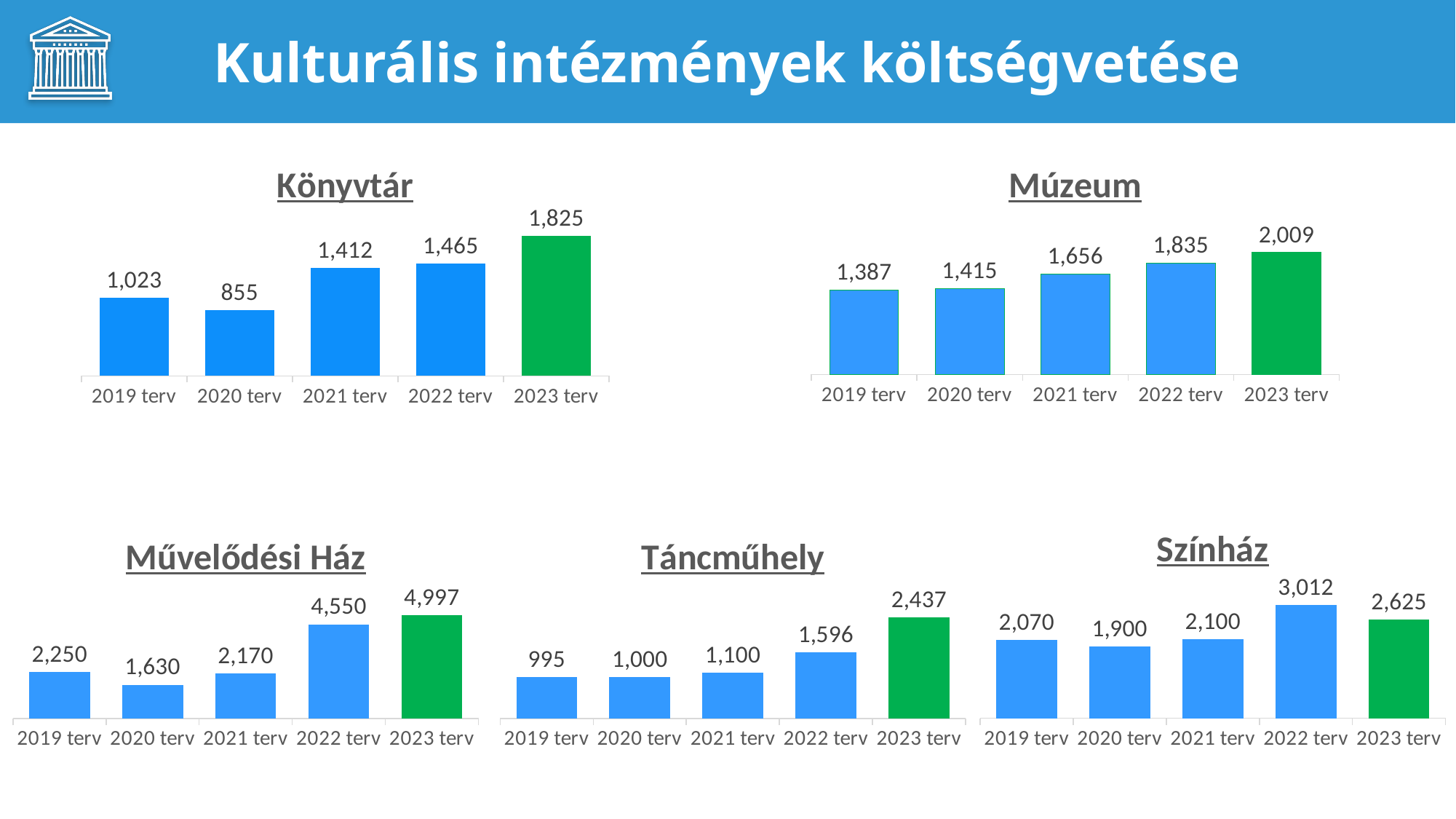
In the Múzeum chart, what is the value for 2021 terv? 1,656 In the Könyvtár chart, what is the value for 2023 terv? 1,825 What kind of chart is the Táncműhely chart? bar chart In the Színház chart, which is larger, the value for 2019 terv or 2020 terv? 2019 terv In the Színház chart, which year has the highest value? 2022 terv In the Táncműhely chart, what is the difference between the 2023 terv and 2022 terv values? 841 In the Könyvtár chart, which year has the lowest value? 2020 terv In the Művelődési Ház chart, which year has the highest value? 2023 terv How many charts are shown on the slide? 5 In the Művelődési Ház chart, what is the difference between the 2022 terv and 2021 terv values? 2,380 In the Múzeum chart, do the values rise or fall from 2019 terv to 2023 terv? rise How many bars does the Múzeum chart have? 5